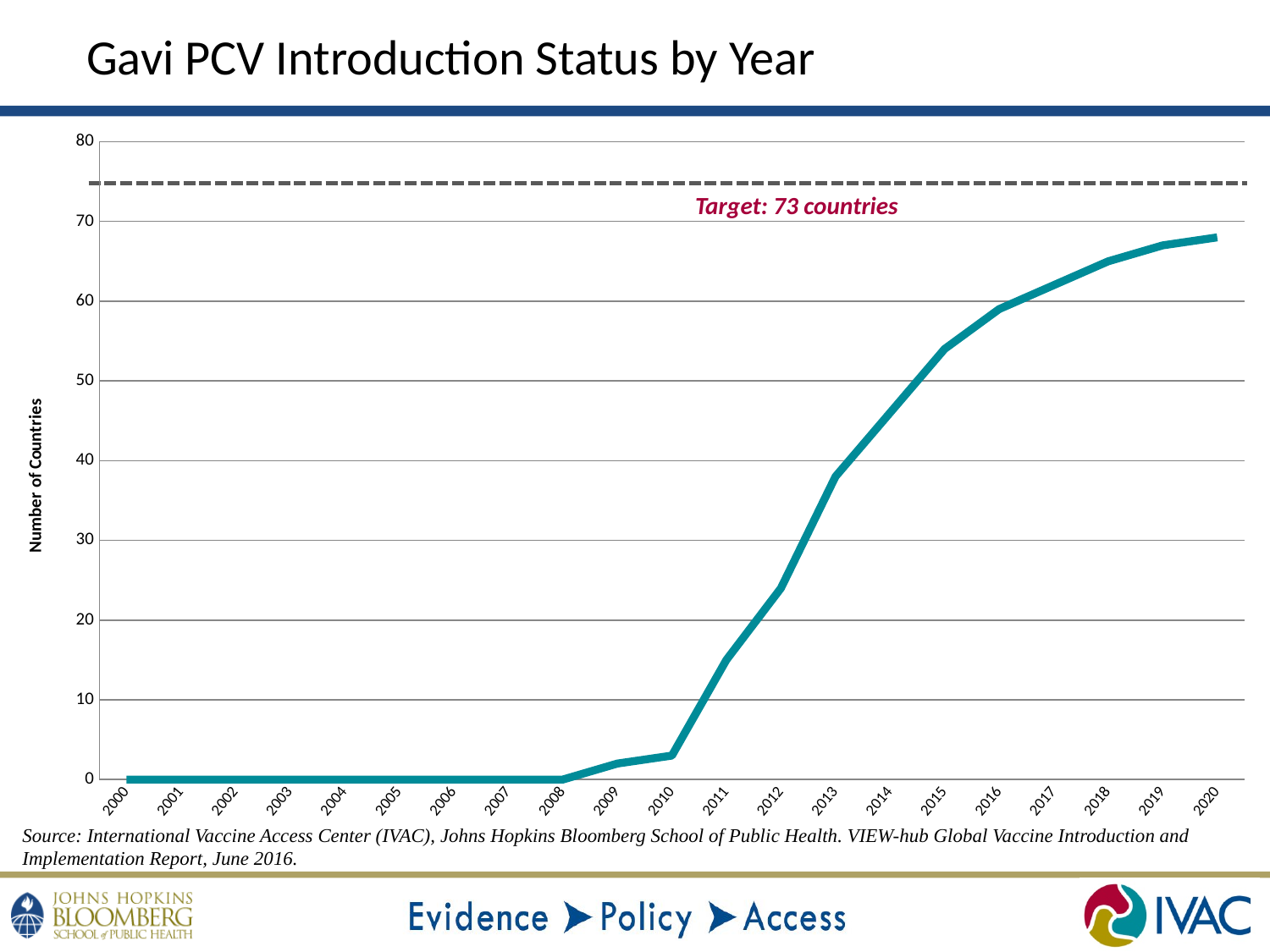
Is the value for 2013 greater or less than 30? greater What target is marked by the dashed line on the chart? Target: 73 countries What is the title of the chart? Gavi PCV Introduction Status by Year What kind of chart is shown on the slide? line chart How many years are shown on the x axis? 21 Is the value for 2020 greater or less than 70? less What is the number of countries for 2008? 0 Do the values rise or fall from 2010 to 2020? rise Which year has the highest number of countries? 2020 Is the value for 2012 greater or less than 30? less What is the number of countries for 2005? 0